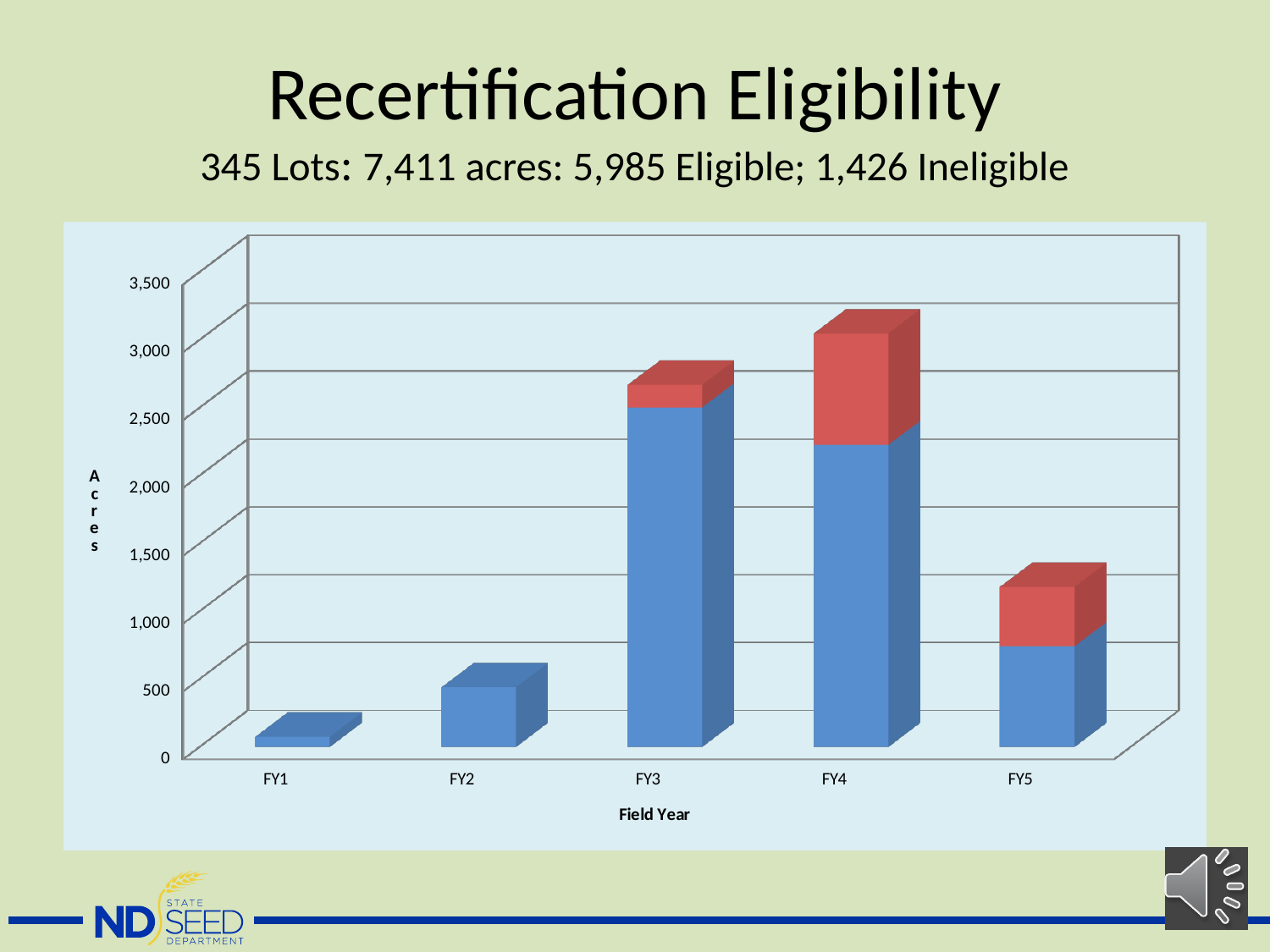
How many field-year categories are plotted on the x axis? 5 Which field year has the shortest bar? FY1 Do the bar heights rise or fall from FY1 to FY4? rise Is the value for FY1 greater or less than 500? less What kind of chart is shown on the slide? Bar chart Is the total value for FY5 greater or less than 1,500? less Which bar is taller, FY3 or FY5? FY3 What is the title of the y axis? Acres Is the total value for FY3 greater or less than 2,000? greater Which field year has the tallest bar? FY4 What is the title of the x axis? Field Year